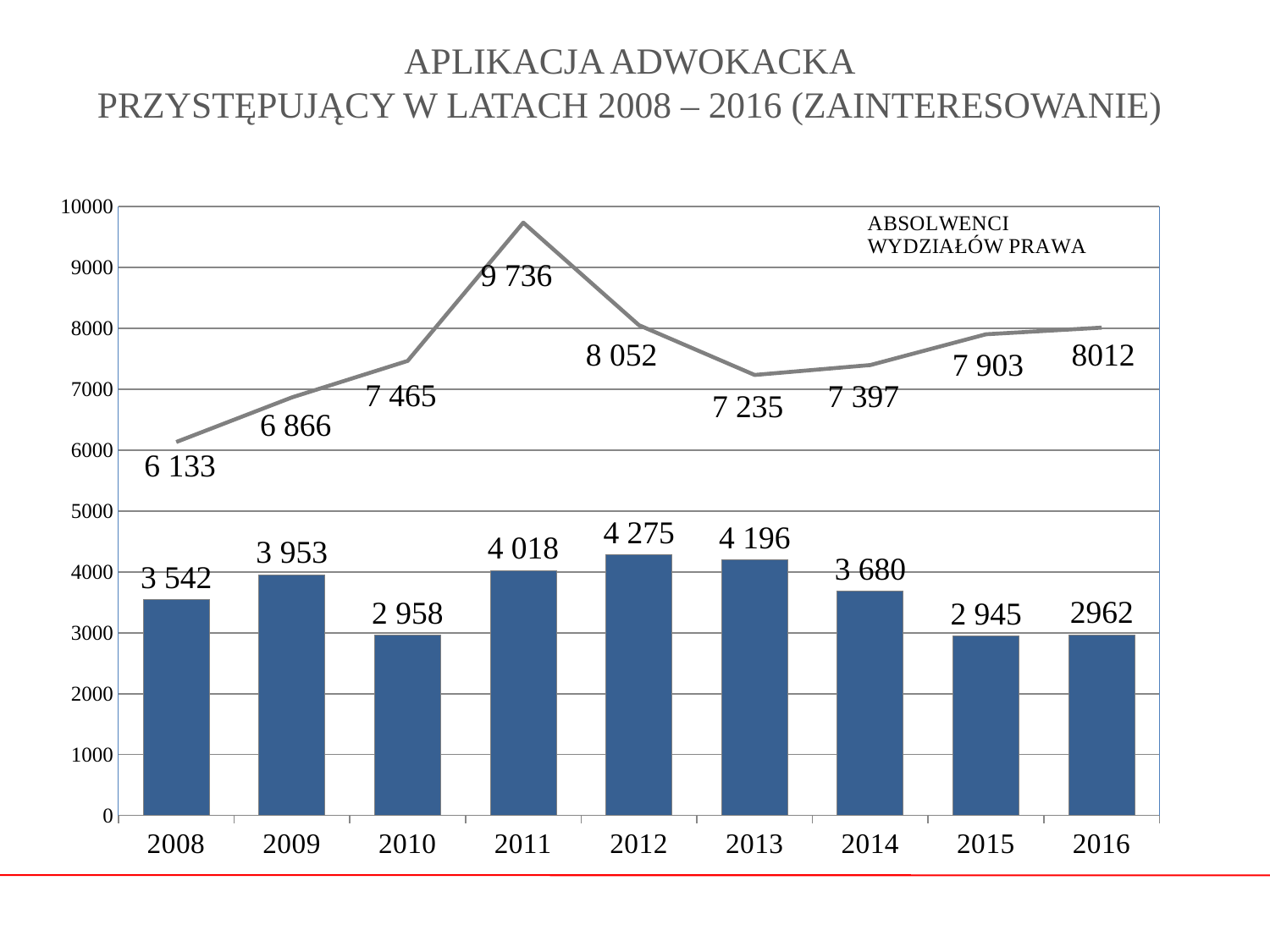
What is the difference between the bar values for 2012 and 2010? 1 317 What is the value of the bar for 2015? 2 945 Which is larger, the bar value for 2009 or the bar value for 2014? 2009 Is the value of the ABSOLWENCI WYDZIAŁÓW PRAWA line for 2013 greater or less than 7000? greater Does the ABSOLWENCI WYDZIAŁÓW PRAWA line rise or fall from 2008 to 2011? Rise What value does the ABSOLWENCI WYDZIAŁÓW PRAWA line show for 2011? 9 736 How many years are shown on the x axis? 9 What is the label of the line series on the chart? ABSOLWENCI WYDZIAŁÓW PRAWA What kind of chart is shown on the slide? Combined bar and line chart Which year has the lowest value on the ABSOLWENCI WYDZIAŁÓW PRAWA line? 2008 What is the value of the bar for 2012? 4 275 Which year has the highest bar? 2012